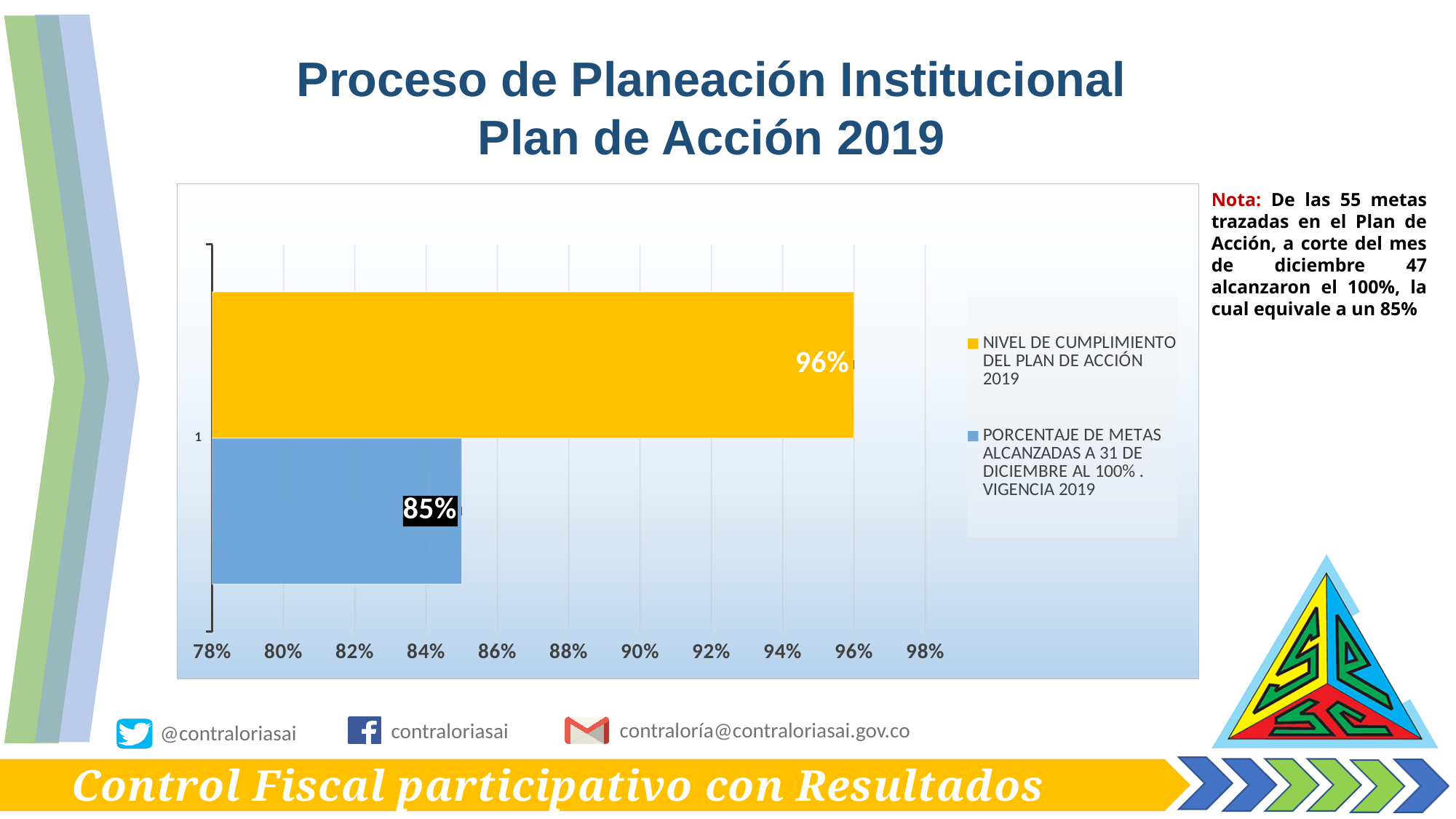
What is the value of PORCENTAJE DE METAS ALCANZADAS A 31 DE DICIEMBRE AL 100% . VIGENCIA 2019? 85% What is the value of NIVEL DE CUMPLIMIENTO DEL PLAN DE ACCIÓN 2019? 96% How many series does the chart legend list? 2 Which series has the lowest value in the chart? PORCENTAJE DE METAS ALCANZADAS A 31 DE DICIEMBRE AL 100% . VIGENCIA 2019 Is the value for NIVEL DE CUMPLIMIENTO DEL PLAN DE ACCIÓN 2019 greater or less than 90%? greater Is the value for PORCENTAJE DE METAS ALCANZADAS A 31 DE DICIEMBRE AL 100% . VIGENCIA 2019 greater or less than 90%? less What colour is the bar for NIVEL DE CUMPLIMIENTO DEL PLAN DE ACCIÓN 2019? Yellow What kind of chart is shown on the slide? Bar chart Which series has the higher value, NIVEL DE CUMPLIMIENTO DEL PLAN DE ACCIÓN 2019 or PORCENTAJE DE METAS ALCANZADAS A 31 DE DICIEMBRE AL 100% . VIGENCIA 2019? NIVEL DE CUMPLIMIENTO DEL PLAN DE ACCIÓN 2019 What is the difference between the NIVEL DE CUMPLIMIENTO DEL PLAN DE ACCIÓN 2019 value and the PORCENTAJE DE METAS ALCANZADAS value? 11% What is the lowest value shown on the chart's horizontal axis? 78%